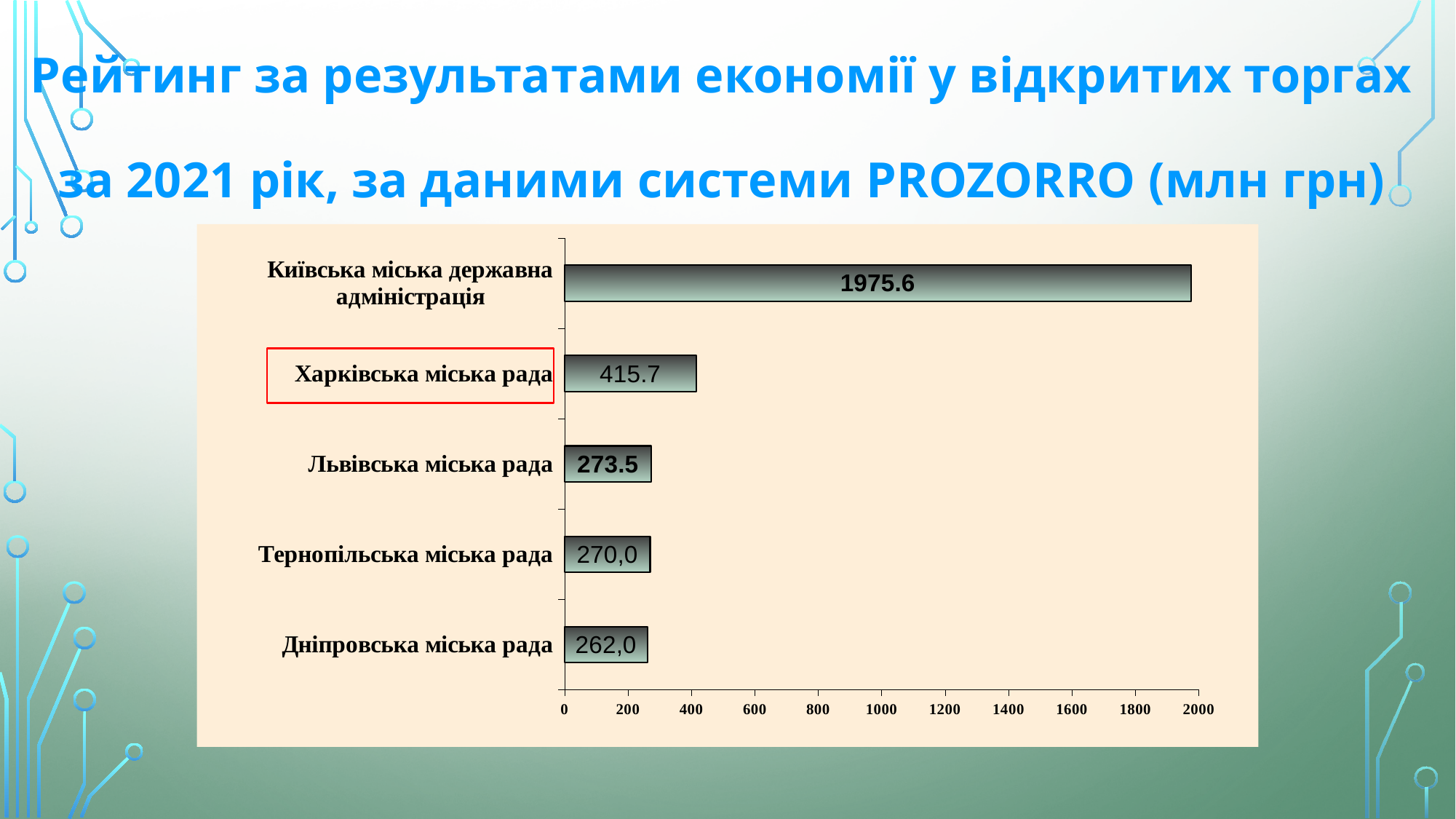
What kind of chart is shown on the slide? Bar chart What is the value for Дніпровська міська рада? 262,0 What is the value for Львівська міська рада? 273.5 What is the difference between the values for Харківська міська рада and Львівська міська рада? 142.2 What is the difference between the values for Київська міська державна адміністрація and Харківська міська рада? 1559.9 What is the value for Київська міська державна адміністрація? 1975.6 What is the value for Тернопільська міська рада? 270,0 What is the value for Харківська міська рада? 415.7 How many categories are shown in the chart? 5 Which category has the highest value? Київська міська державна адміністрація Which category has the lowest value? Дніпровська міська рада Which is larger, the value for Харківська міська рада or the value for Львівська міська рада? Харківська міська рада